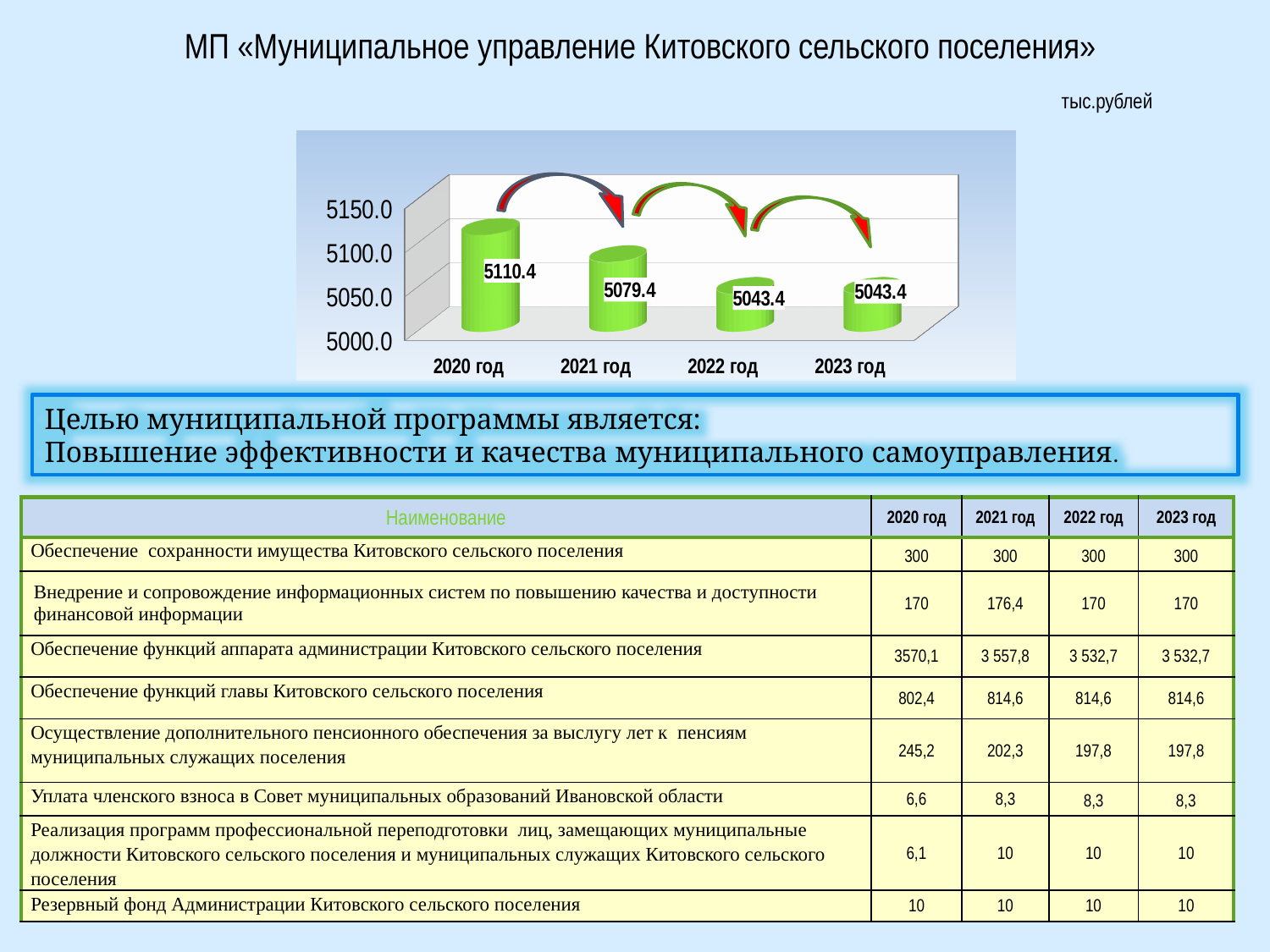
Which is larger in the chart, the value for 2020 год or the value for 2022 год? 2020 год What is the difference between the values for 2020 год and 2021 год in the chart? 31.0 What kind of chart is shown on the slide? bar chart Is the value for 2021 год greater or less than 5100.0? less What is the value for 2023 год in the chart? 5043.4 What is the value for 2020 год in the chart? 5110.4 In what units are the chart values given, according to the label above the chart? тыс.рублей Do the values in the chart rise or fall from 2020 год to 2022 год? fall What is the difference between the values for 2021 год and 2022 год in the chart? 36.0 How many years are shown on the x axis of the chart? 4 Which year has the highest value in the chart? 2020 год What is the value for 2021 год in the chart? 5079.4